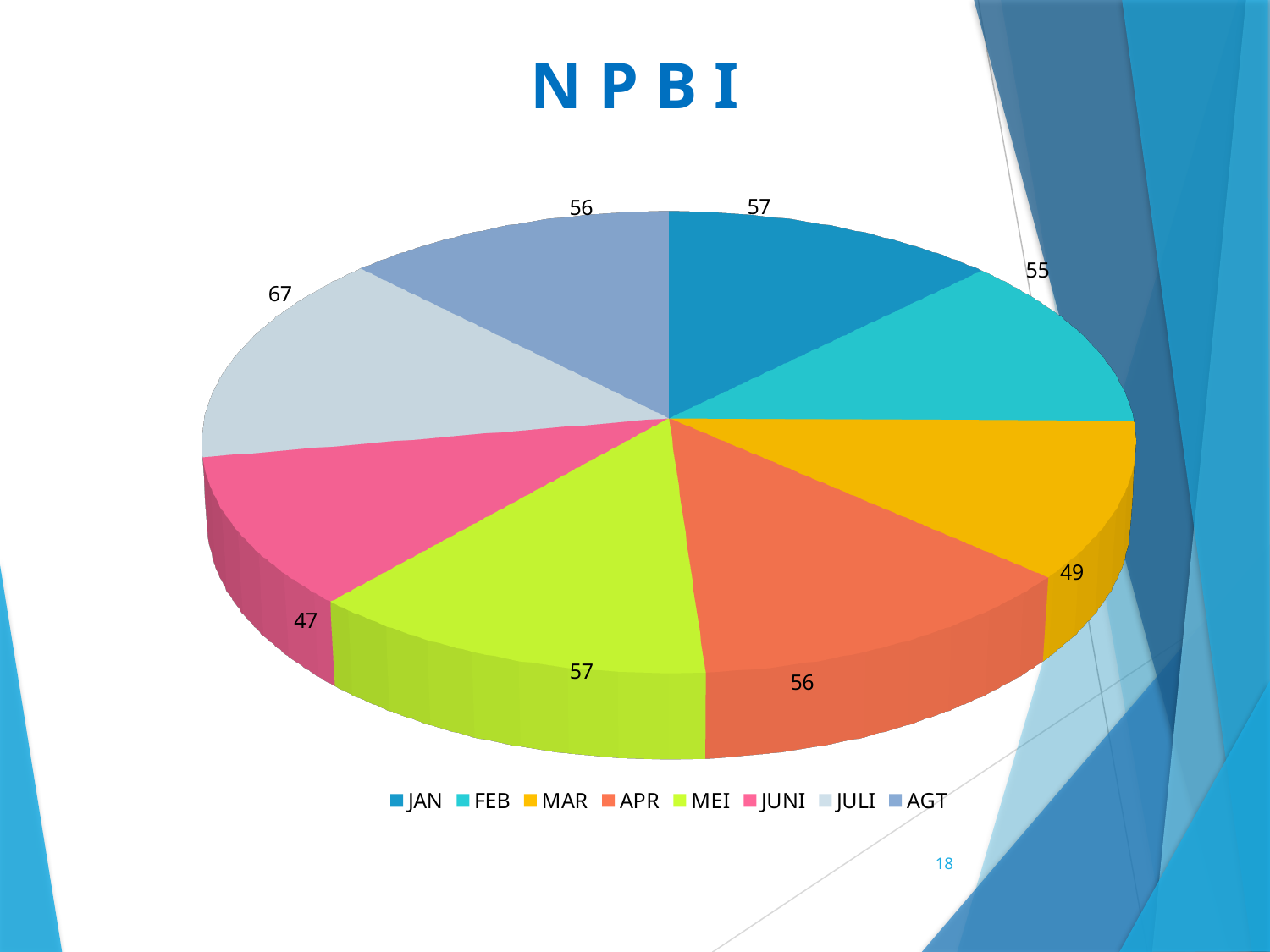
How many slices does the pie chart have? 8 Which month has the smallest slice? JUNI What is the title of the chart? N P B I What is the value for FEB? 55 What is the value for JUNI? 47 What is the difference between the values for APR and MAR? 7 Which month has the largest slice? JULI What is the value for MAR? 49 What is the value for JULI? 67 What type of chart is shown on the slide? pie chart What is the difference between the values for JULI and JUNI? 20 Which is larger, the value for FEB or the value for MAR? FEB